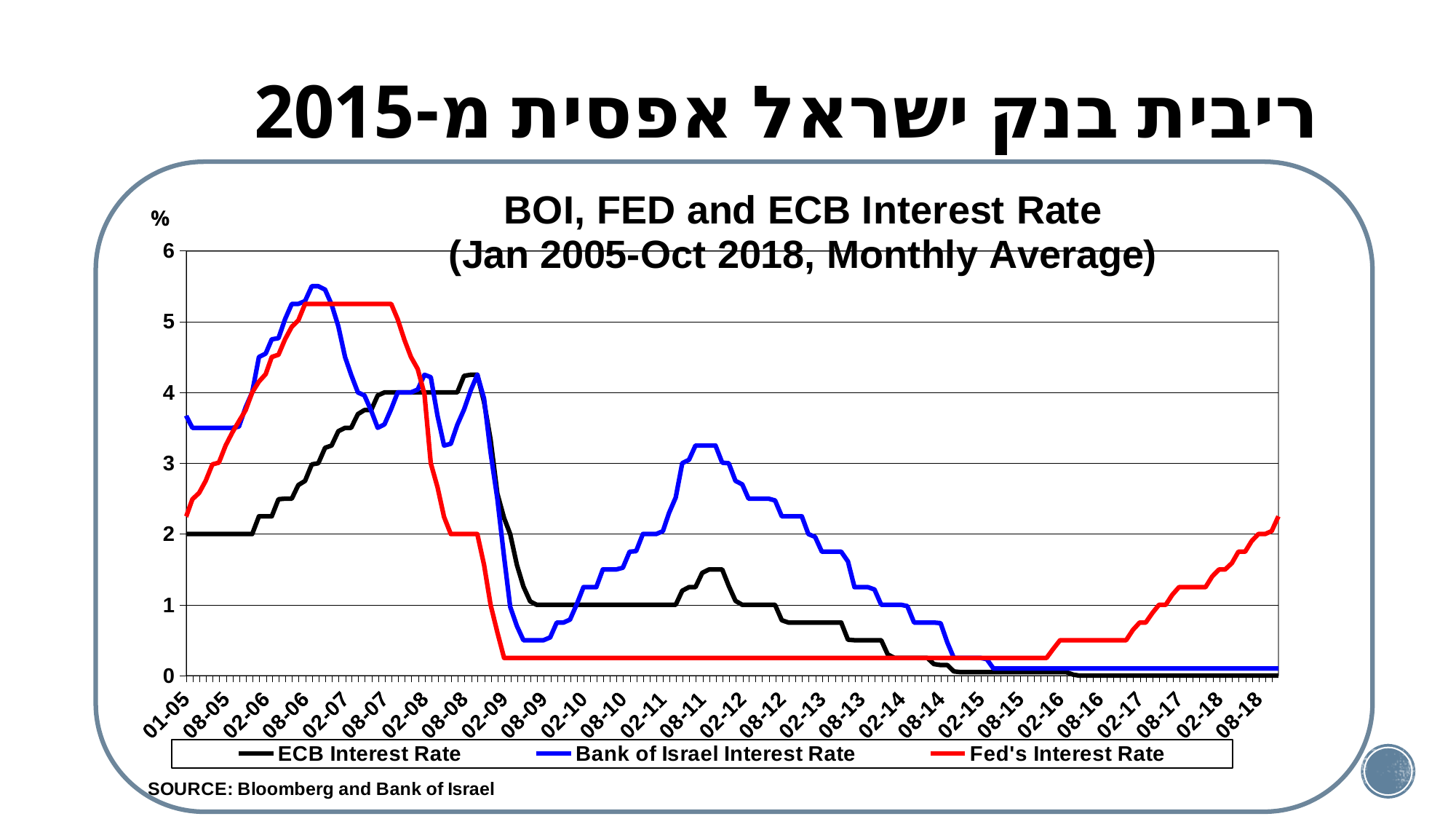
Is the Bank of Israel Interest Rate at 08-11 greater or less than 3? greater Is the Bank of Israel Interest Rate at 02-07 greater or less than 5? less Does the Fed's Interest Rate rise or fall between 02-16 and 08-18? rise What source is cited below the chart? Bloomberg and Bank of Israel What is the title of the chart? BOI, FED and ECB Interest Rate (Jan 2005-Oct 2018, Monthly Average) Which series has the highest value at 01-05? Bank of Israel Interest Rate What kind of chart is shown on the slide? line chart Is the ECB Interest Rate at 08-08 greater or less than 4? greater How many series does the legend list? 3 Which series has the lowest value at 08-18? ECB Interest Rate